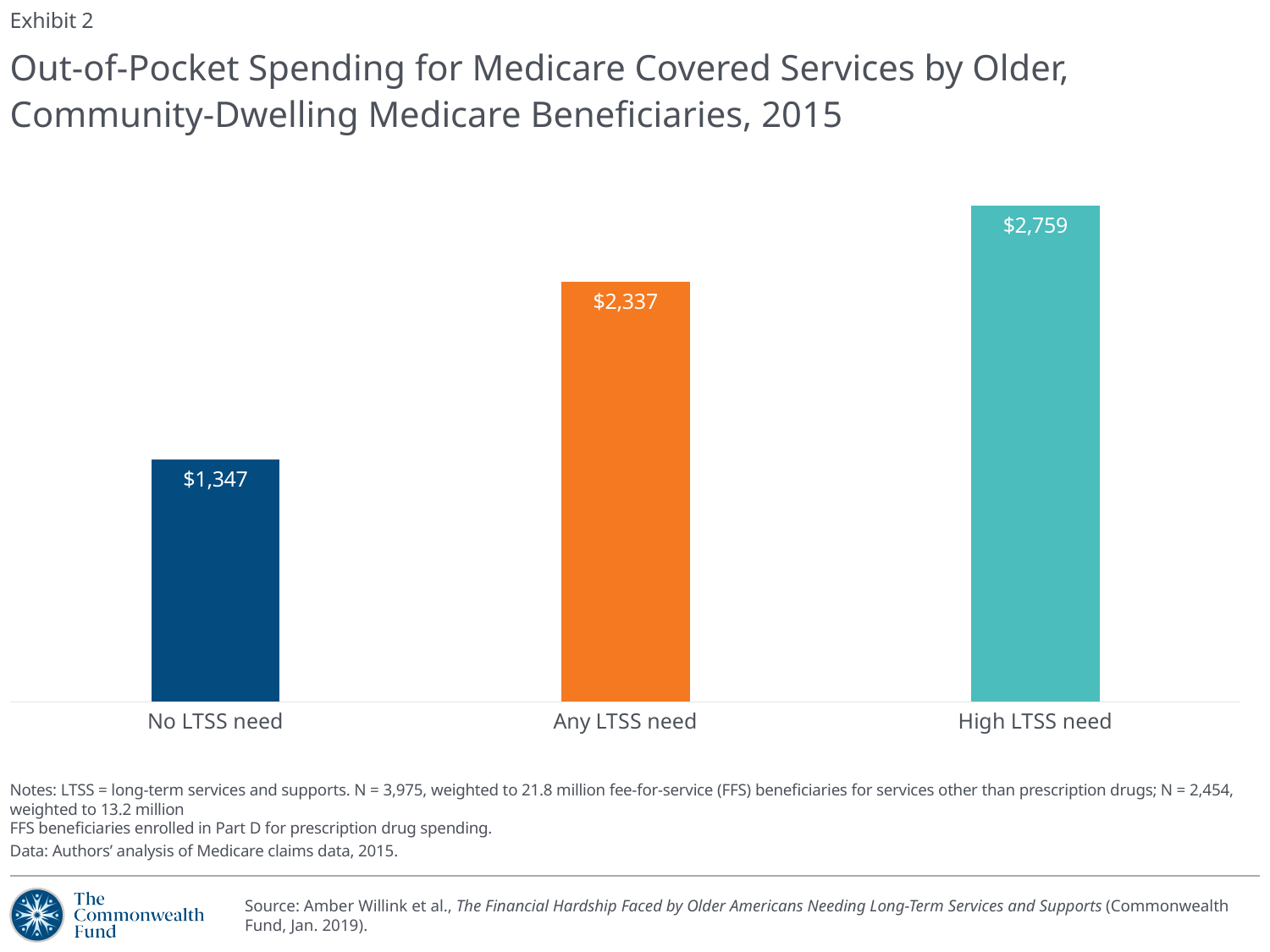
How many categories are shown in the chart? 3 What is the difference in out-of-pocket spending between High LTSS need and No LTSS need? $1,412 Which category has the lowest out-of-pocket spending? No LTSS need Do the values rise or fall moving from left to right across the categories? Rise Which is larger, the out-of-pocket spending for Any LTSS need or for High LTSS need? High LTSS need What is the difference in out-of-pocket spending between Any LTSS need and No LTSS need? $990 Which category has the highest out-of-pocket spending? High LTSS need What colour is the bar for Any LTSS need? Orange What is the out-of-pocket spending value for beneficiaries with high LTSS need? $2,759 What is the out-of-pocket spending value for beneficiaries with any LTSS need? $2,337 What is the out-of-pocket spending value for beneficiaries with no LTSS need? $1,347 What kind of chart is shown on the slide? Bar chart